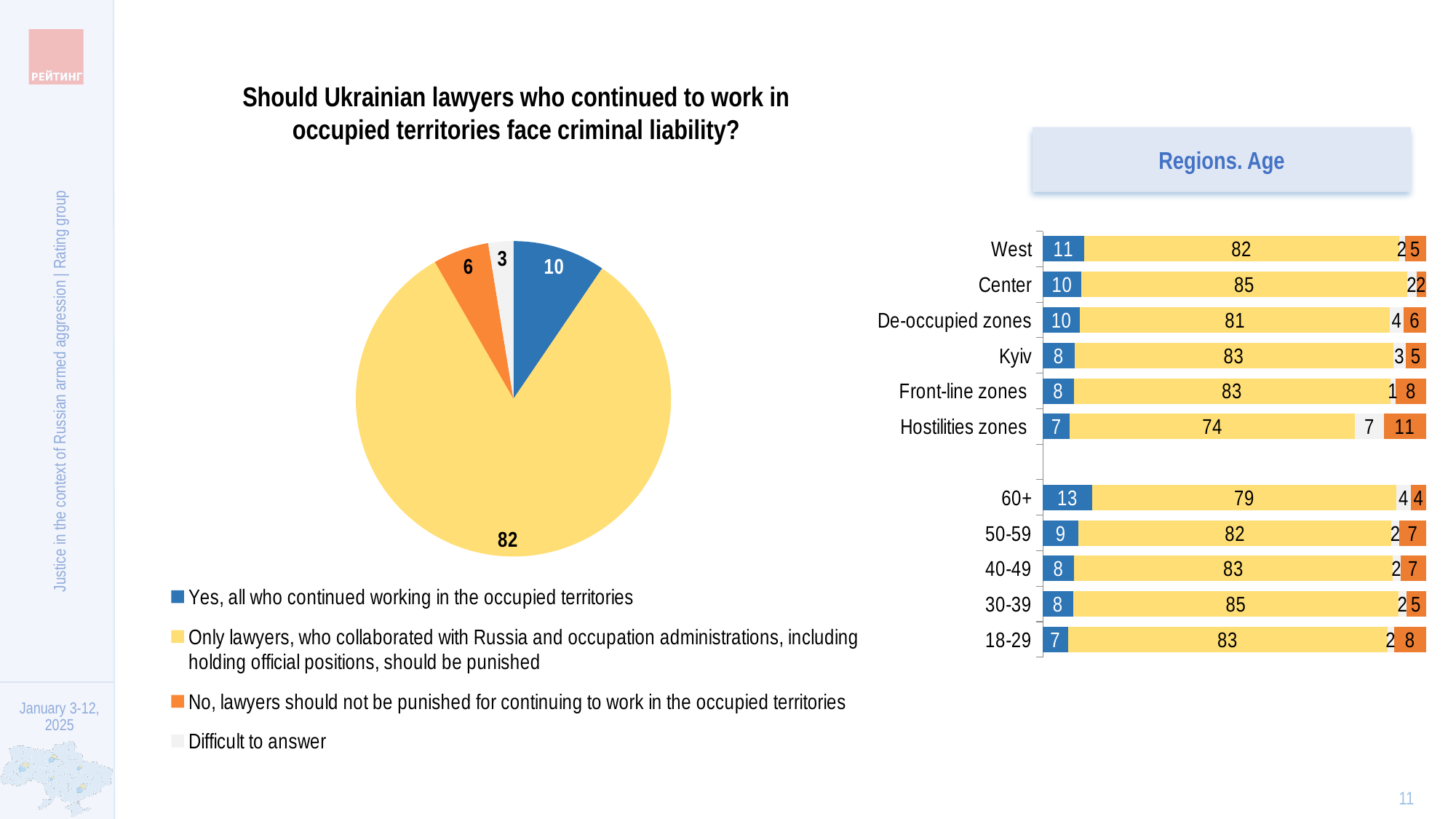
In the "Regions. Age" chart, which is larger for "Yes, all who continued working in the occupied territories": West or 18-29? West In the "Regions. Age" chart, what is the total of the West bar? 100 What kind of chart is the "Regions. Age" chart? Bar chart In the "Regions. Age" chart, what is the difference between Center and Hostilities zones for "Only lawyers, who collaborated with Russia..."? 11 What kind of chart is the chart on the left of the slide? Pie chart How many response options does the legend list? 4 In the "Regions. Age" chart, what is the value for "Yes, all who continued working in the occupied territories" for the 60+ age group? 13 In the pie chart, which response has the largest slice? Only lawyers, who collaborated with Russia and occupation administrations, including holding official positions, should be punished In the "Regions. Age" chart, which region has the highest value for "No, lawyers should not be punished"? Hostilities zones In the "Regions. Age" chart, what is the value for "Only lawyers, who collaborated with Russia..." in Hostilities zones? 74 How many categories (regions and age groups) are shown in the "Regions. Age" chart? 11 In the pie chart, what is the value for "Difficult to answer"? 3